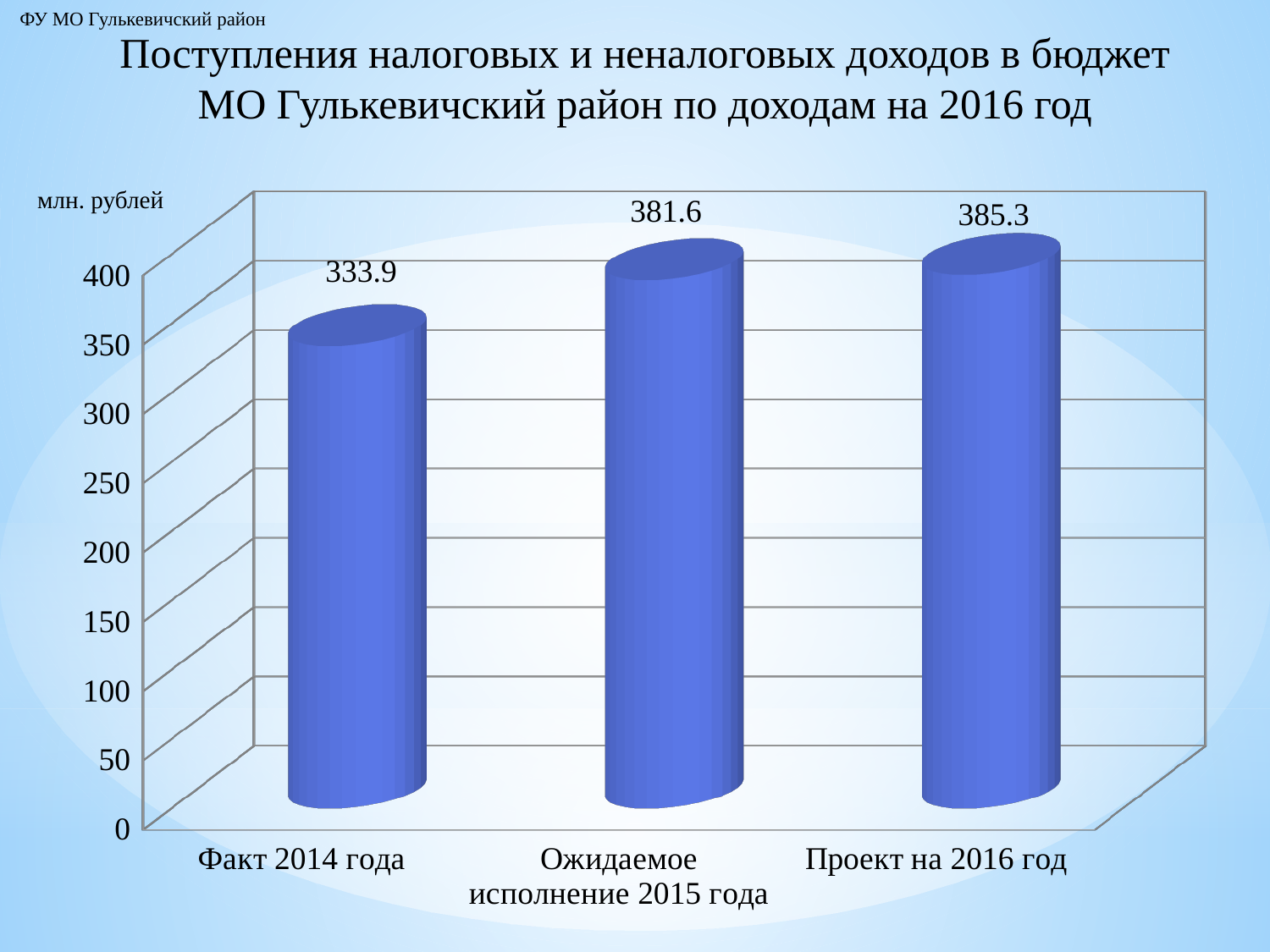
What is the difference between the values for Ожидаемое исполнение 2015 года and Факт 2014 года? 47.7 What is the value for Факт 2014 года? 333.9 Which category has the lowest value? Факт 2014 года Do the values rise or fall from Факт 2014 года to Проект на 2016 год? rise What is the value for Проект на 2016 год? 385.3 What kind of chart is shown on the slide? bar chart What is the value for Ожидаемое исполнение 2015 года? 381.6 Is the value for Факт 2014 года greater or less than 350? less How many categories are shown on the chart? 3 Which category has the highest value? Проект на 2016 год What is the difference between the values for Проект на 2016 год and Факт 2014 года? 51.4 Which is larger, the value for Ожидаемое исполнение 2015 года or the value for Факт 2014 года? Ожидаемое исполнение 2015 года